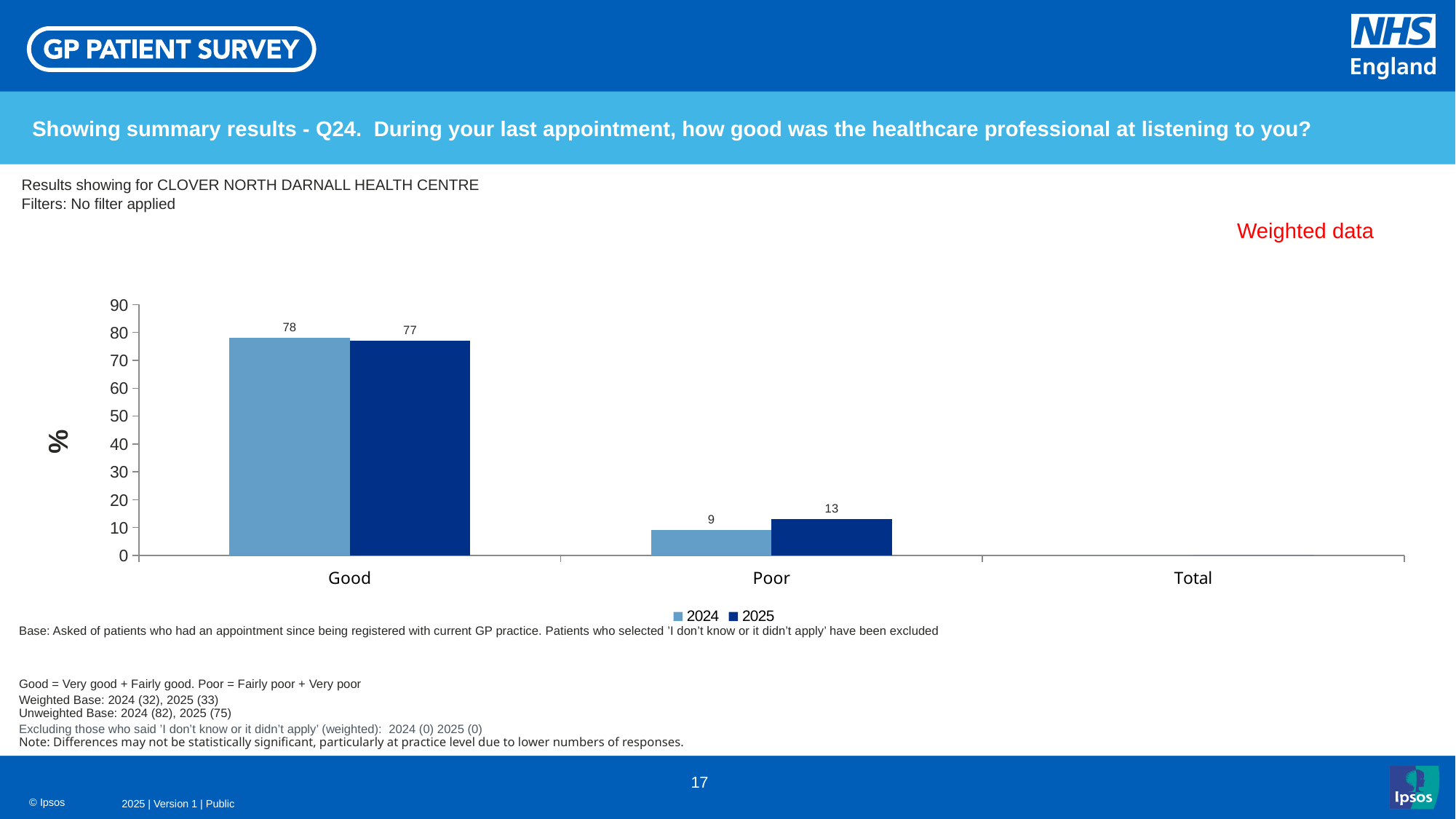
Which category has the highest value for 2025? Good What is the value for Good in 2025? 77 Is the value for Poor in 2025 greater or less than 20? less How many series does the legend list? 2 What is the value for Poor in 2024? 9 What label is shown on the vertical axis? % Which is larger, the 2024 value for Good or the 2025 value for Good? 2024 What is the difference between the 2025 and 2024 values for Poor? 4 What is the value for Poor in 2025? 13 Which category has the lowest value for 2024? Poor What kind of chart is shown on the slide? Bar chart What is the value for Good in 2024? 78